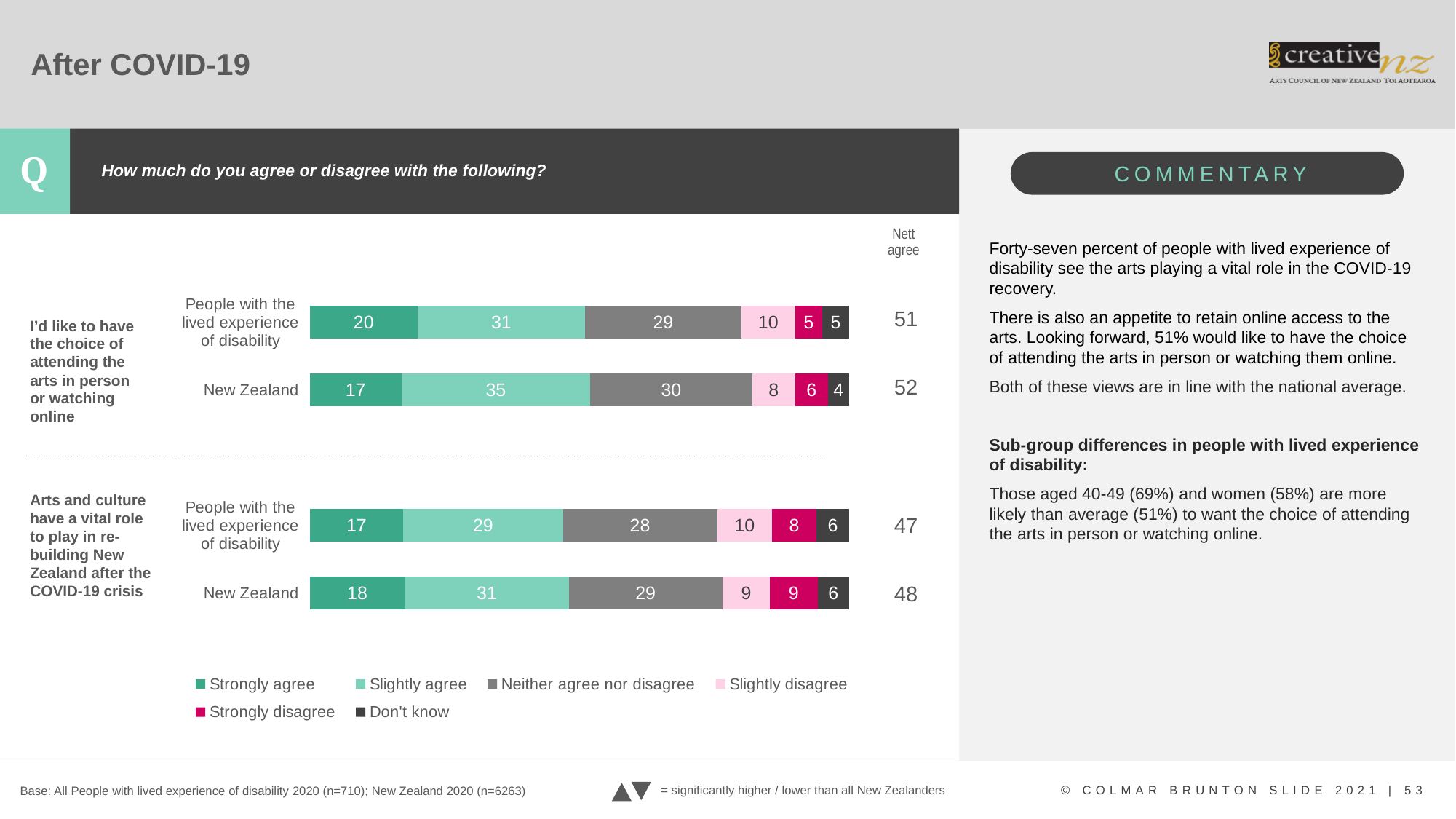
What is the Nett agree figure for People with the lived experience of disability on the statement 'Arts and culture have a vital role to play in re-building New Zealand after the COVID-19 crisis'? 47 Which group has the higher Nett agree figure for the statement 'I'd like to have the choice of attending the arts in person or watching online': People with the lived experience of disability or New Zealand? New Zealand How many bars are plotted on the chart? 4 What kind of chart is shown on the slide? Stacked bar chart What is the 'Slightly agree' value for New Zealand on the statement 'I'd like to have the choice of attending the arts in person or watching online'? 35 Which segment is the largest in the New Zealand bar for the statement 'I'd like to have the choice of attending the arts in person or watching online'? Slightly agree What is the total of the 'Strongly agree' and 'Slightly agree' segments for New Zealand on the statement 'Arts and culture have a vital role to play in re-building New Zealand after the COVID-19 crisis'? 49 How many series does the legend list? 6 What is the difference between the 'Neither agree nor disagree' values for People with the lived experience of disability and New Zealand on the statement 'Arts and culture have a vital role to play in re-building New Zealand after the COVID-19 crisis'? 1 What is the 'Strongly agree' value for People with the lived experience of disability on the statement 'I'd like to have the choice of attending the arts in person or watching online'? 20 What is the 'Don't know' value for People with the lived experience of disability on the statement 'Arts and culture have a vital role to play in re-building New Zealand after the COVID-19 crisis'? 6 What is the 'Strongly disagree' value for New Zealand on the statement 'Arts and culture have a vital role to play in re-building New Zealand after the COVID-19 crisis'? 9